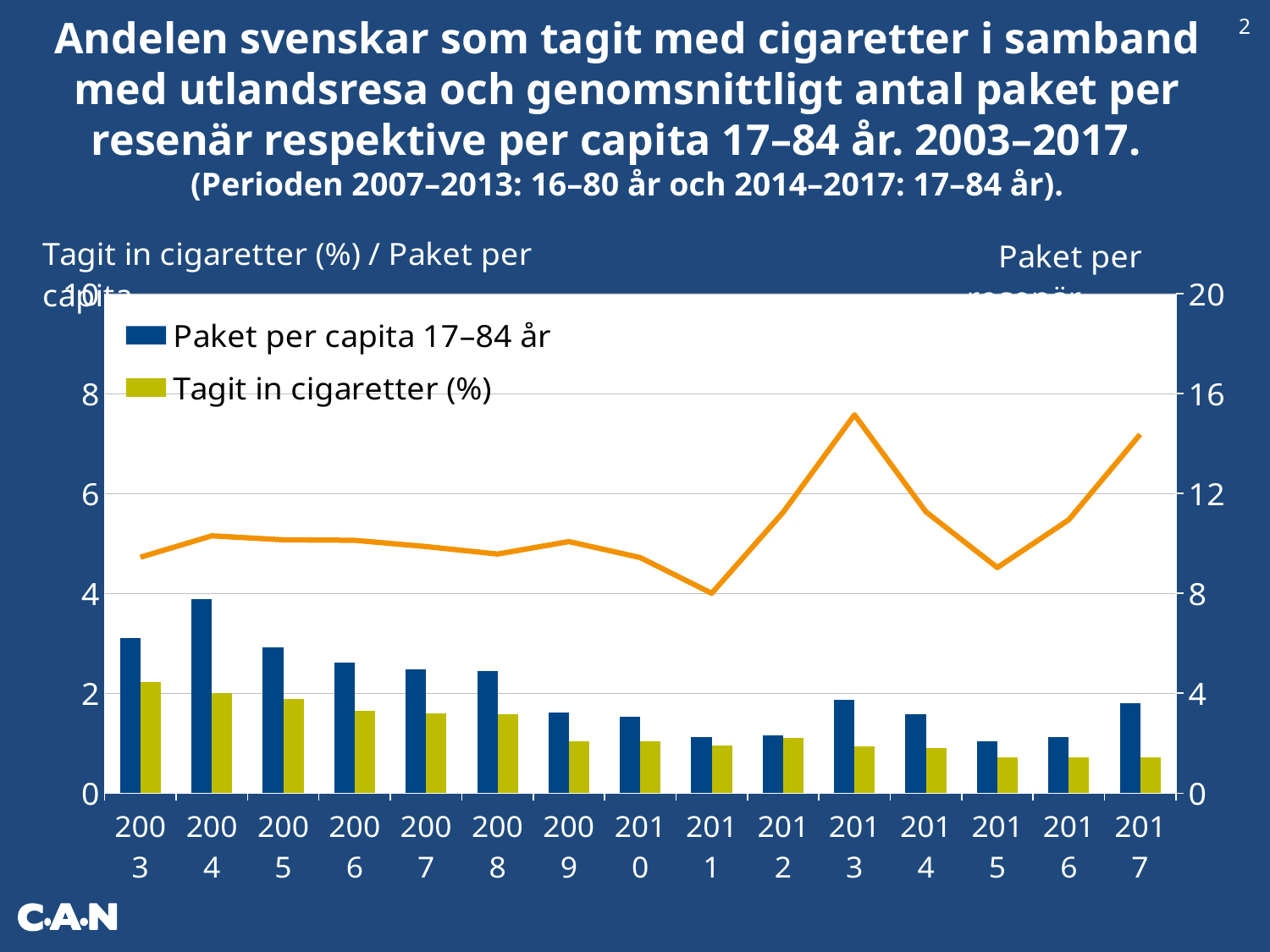
On the right-hand axis, is the Paket per resenär value in 2013 greater or less than 12? greater How many years are shown on the x axis of the chart? 15 Which is larger: Paket per capita 17–84 år in 2004 or in 2005? 2004 What kind of chart is shown on the slide? A combined bar and line chart Do the Paket per capita 17–84 år bars generally rise or fall from 2003 to 2017? fall In which year does the orange Paket per resenär line reach its highest point? 2013 Is the value for Paket per capita 17–84 år in 2010 greater or less than 2? less Which year has the highest value for Paket per capita 17–84 år? 2004 Which year has the highest value for Tagit in cigaretter (%)? 2003 How many series does the chart's legend list? 2 In which year does the orange Paket per resenär line reach its lowest point? 2011 Is the value for Paket per capita 17–84 år in 2004 greater or less than 2? greater